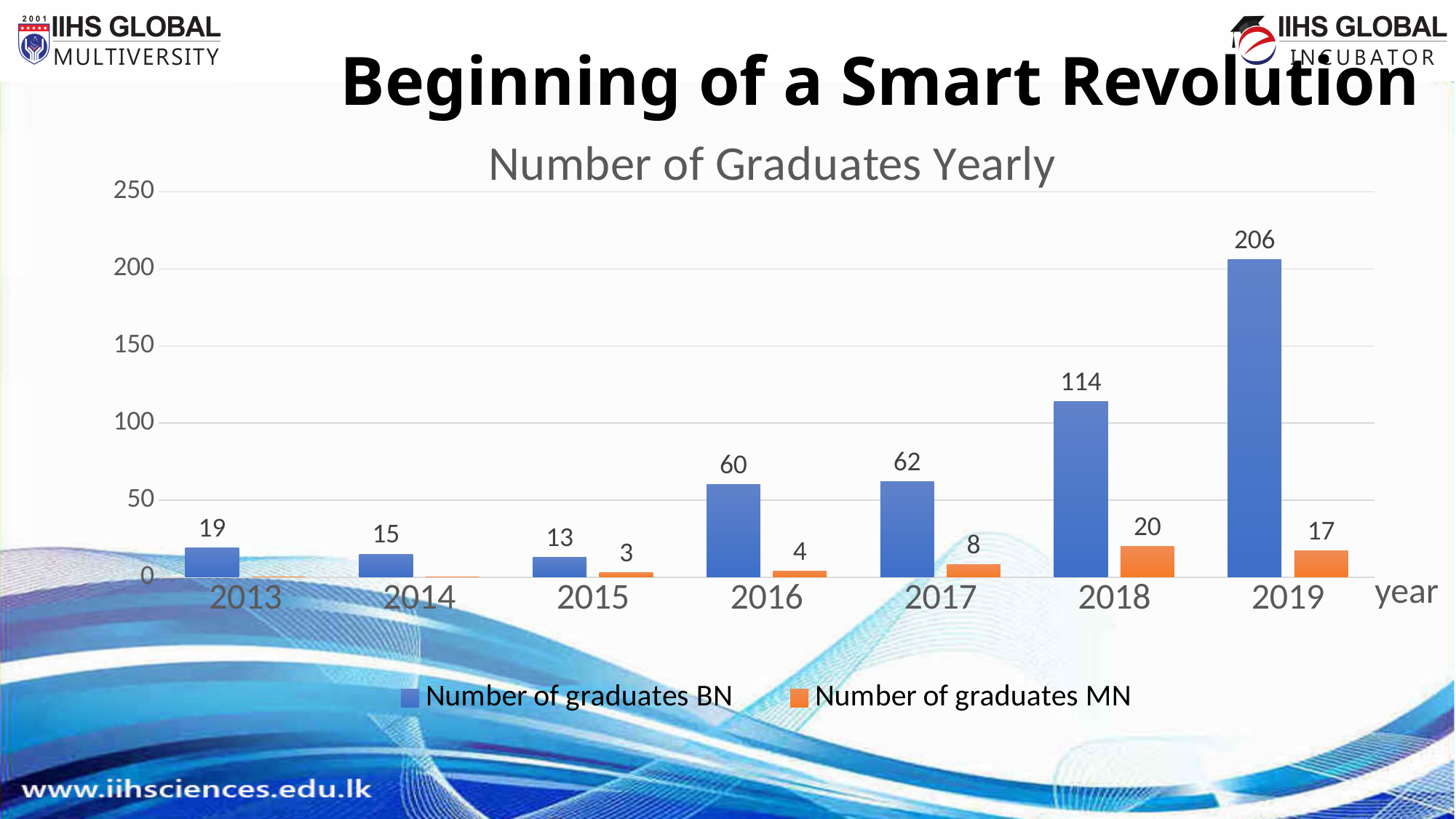
What is the difference between the number of graduates BN in 2019 and in 2018? 92 Which is larger, the number of graduates MN in 2018 or in 2019? 2018 How many series does the legend list? 2 Is the number of graduates BN in 2018 greater or less than 100? greater How many years are shown on the x axis? 7 What is the number of graduates BN in 2019? 206 What is the number of graduates BN in 2015? 13 What kind of chart is shown on the slide? bar chart Which year has the highest number of graduates BN? 2019 Which year has the lowest number of graduates BN? 2015 What is the number of graduates MN in 2018? 20 What is the title of the chart? Number of Graduates Yearly